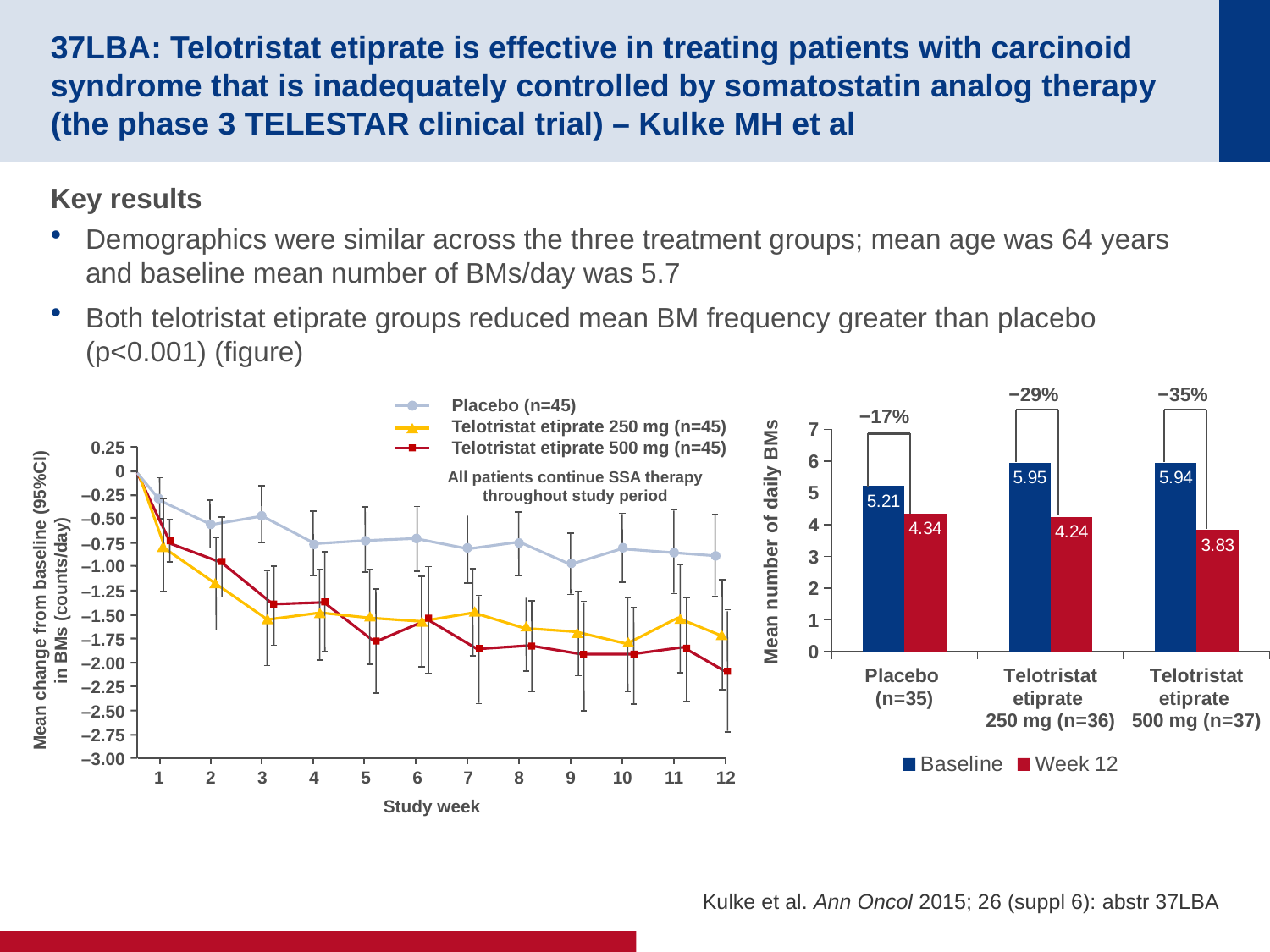
In the line chart on the left, is the placebo value at study week 12 greater or less than −1.50? greater What kind of chart is the chart on the left showing mean change from baseline in BMs? Line chart In the bar chart on the right, what percentage change is shown above the telotristat etiprate 500 mg bars? −35% How many series does the legend of the bar chart on the right list? 2 In the bar chart on the right, what is the difference between the baseline and Week 12 values for the placebo group? 0.87 How many series does the legend of the line chart on the left list? 3 In the bar chart on the right, which is larger: the Week 12 value for placebo or the Week 12 value for telotristat etiprate 250 mg? Placebo In the bar chart on the right, what is the Week 12 value for the telotristat etiprate 250 mg group? 4.24 In the line chart on the left, how many study weeks are shown on the x axis? 12 In the bar chart on the right, what is the Week 12 mean number of daily BMs for the telotristat etiprate 500 mg group? 3.83 In the bar chart on the right, what is the baseline mean number of daily BMs for the placebo group? 5.21 In the bar chart on the right, which group has the lowest Week 12 mean number of daily BMs? Telotristat etiprate 500 mg (n=37)